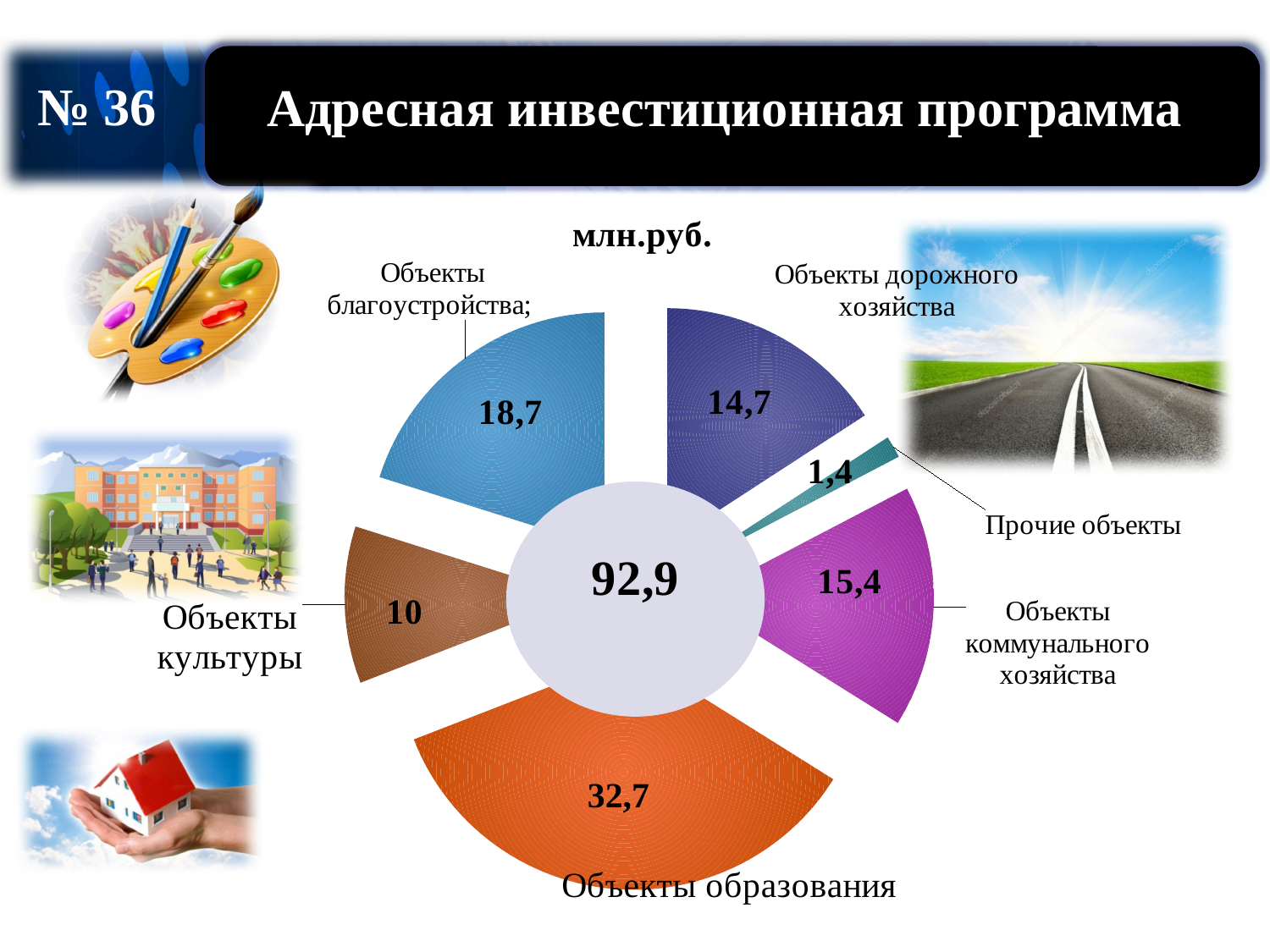
Which category has the smallest value? Прочие объекты What is the difference between Объекты образования and Объекты благоустройства? 14 What total value is shown in the centre of the chart? 92,9 What unit is given in the chart title? млн.руб. What is the value for Объекты коммунального хозяйства? 15,4 Which category has the largest value? Объекты образования Which is larger: Объекты дорожного хозяйства or Объекты коммунального хозяйства? Объекты коммунального хозяйства What is the value for Объекты образования? 32,7 What is the value for Объекты культуры? 10 What kind of chart is shown on the slide? pie chart How many categories are shown in the chart? 6 What is the value for Объекты благоустройства? 18,7